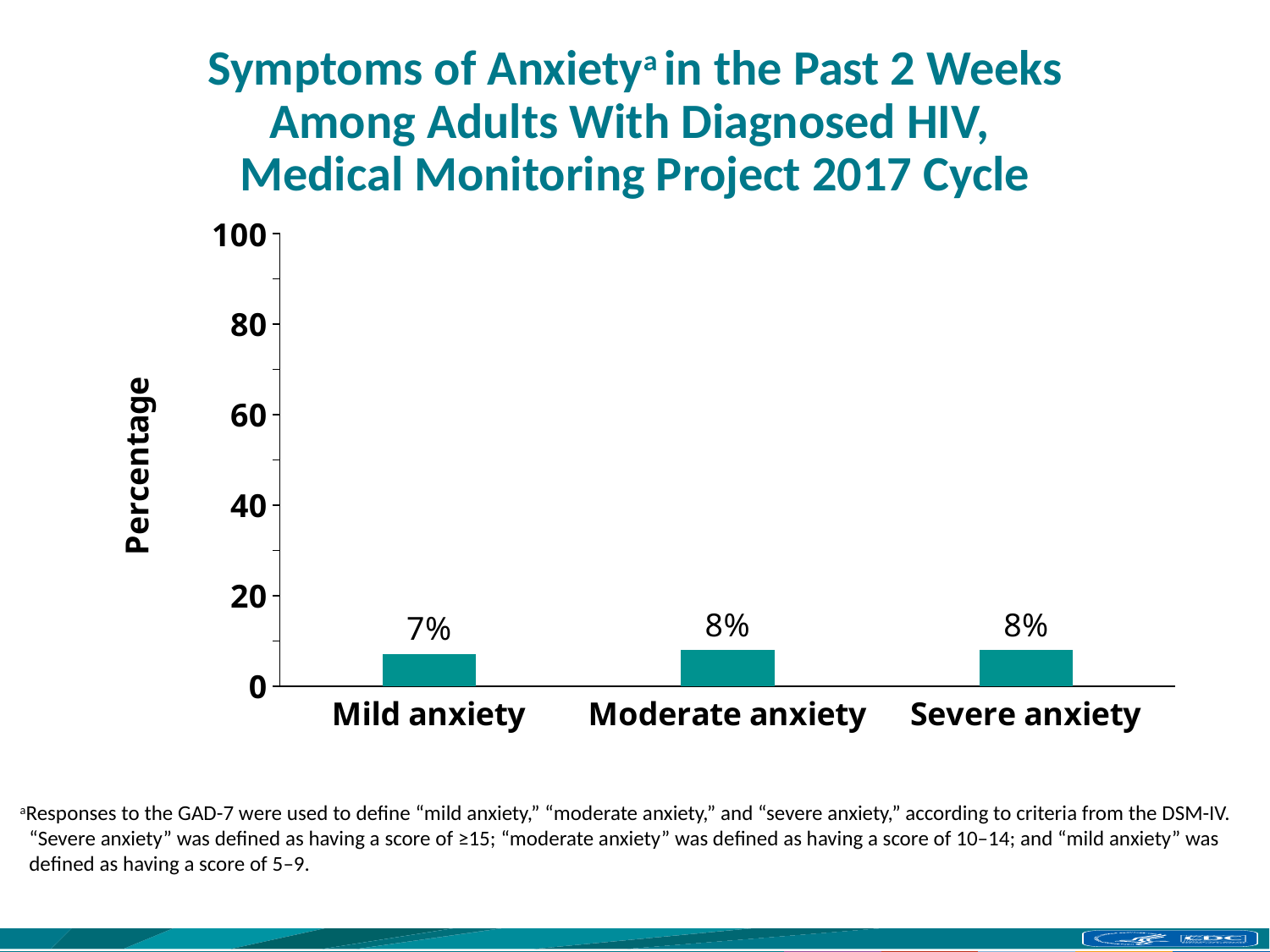
Which is larger, the value for mild anxiety or the value for severe anxiety? Severe anxiety What percentage of adults with diagnosed HIV reported moderate anxiety? 8% What is the difference between the percentage for moderate anxiety and the percentage for mild anxiety? 1% What percentage of adults with diagnosed HIV reported mild anxiety? 7% Do the values for moderate anxiety and severe anxiety differ? No, both are 8% Is the value for moderate anxiety greater or less than 20? less How many anxiety categories are shown on the x axis? 3 What kind of chart is shown on the slide? Bar chart What is the maximum value shown on the y axis? 100 What is the label on the y axis? Percentage What percentage of adults with diagnosed HIV reported severe anxiety? 8% Which anxiety category has the lowest percentage? Mild anxiety